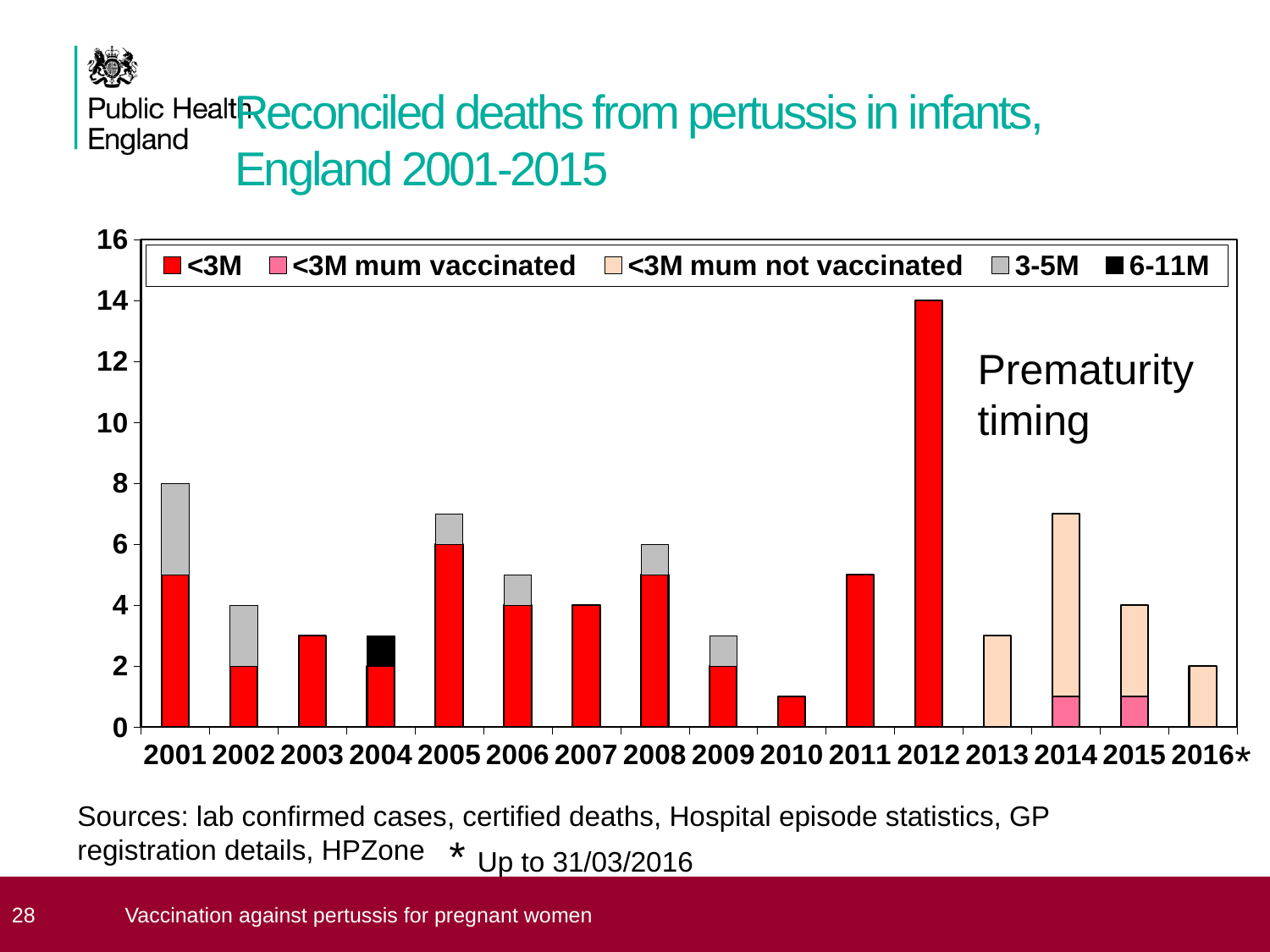
How many series does the legend list? 5 How many years are shown along the x axis? 16 Is the total for 2014 greater or less than 6? greater Which year has the larger total, 2001 or 2002? 2001 Is the total for 2013 greater or less than 4? less Which year has the lowest total number of deaths? 2010 What is the total number of deaths in 2016*? 2 What kind of chart is shown on the slide? Bar chart What is the total number of deaths in 2012? 14 What is the number of deaths in 2007? 4 Which year has the highest total number of deaths? 2012 Which legend series is shown in black? 6-11M